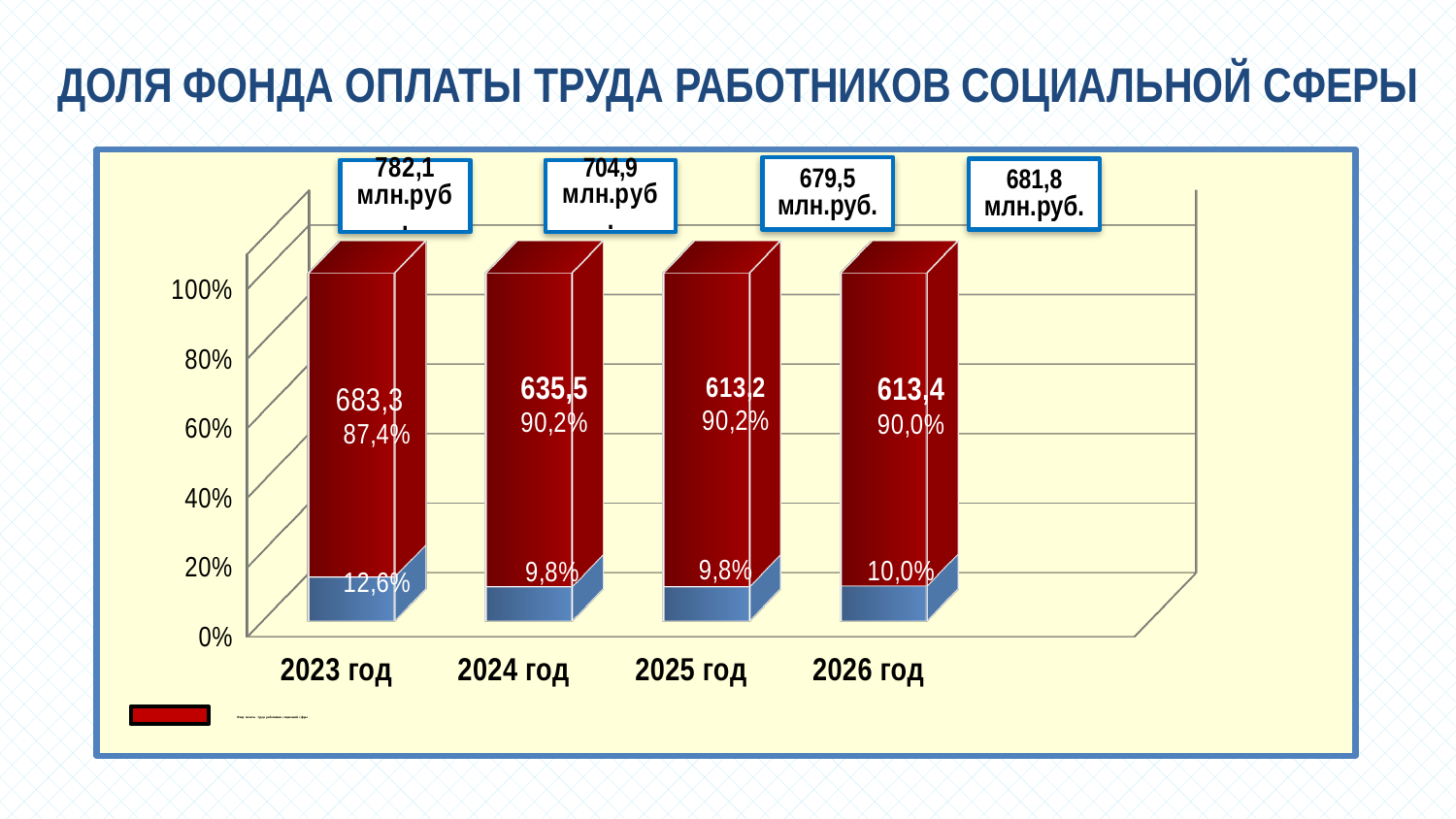
Which year has the larger blue-segment percentage, 2023 год or 2024 год? 2023 год What is the total of the red and blue percentages for 2023 год? 100% What value is printed in the red segment of the bar for 2024 год? 635,5 Which year has the highest percentage in the blue segment? 2023 год What value is shown in the box above the bar for 2025 год? 679,5 млн.руб. What percentage is shown in the blue segment of the bar for 2026 год? 10,0% What is the difference between the red-segment values for 2023 год (683,3) and 2025 год (613,2)? 70,1 Which year has the lowest percentage in the red segment? 2023 год What kind of chart is shown on the slide? Stacked bar chart How many years are shown on the x axis? 4 Does the value printed in the red segment rise or fall from 2023 год to 2025 год? Fall What percentage is shown in the red segment of the bar for 2023 год? 87,4%